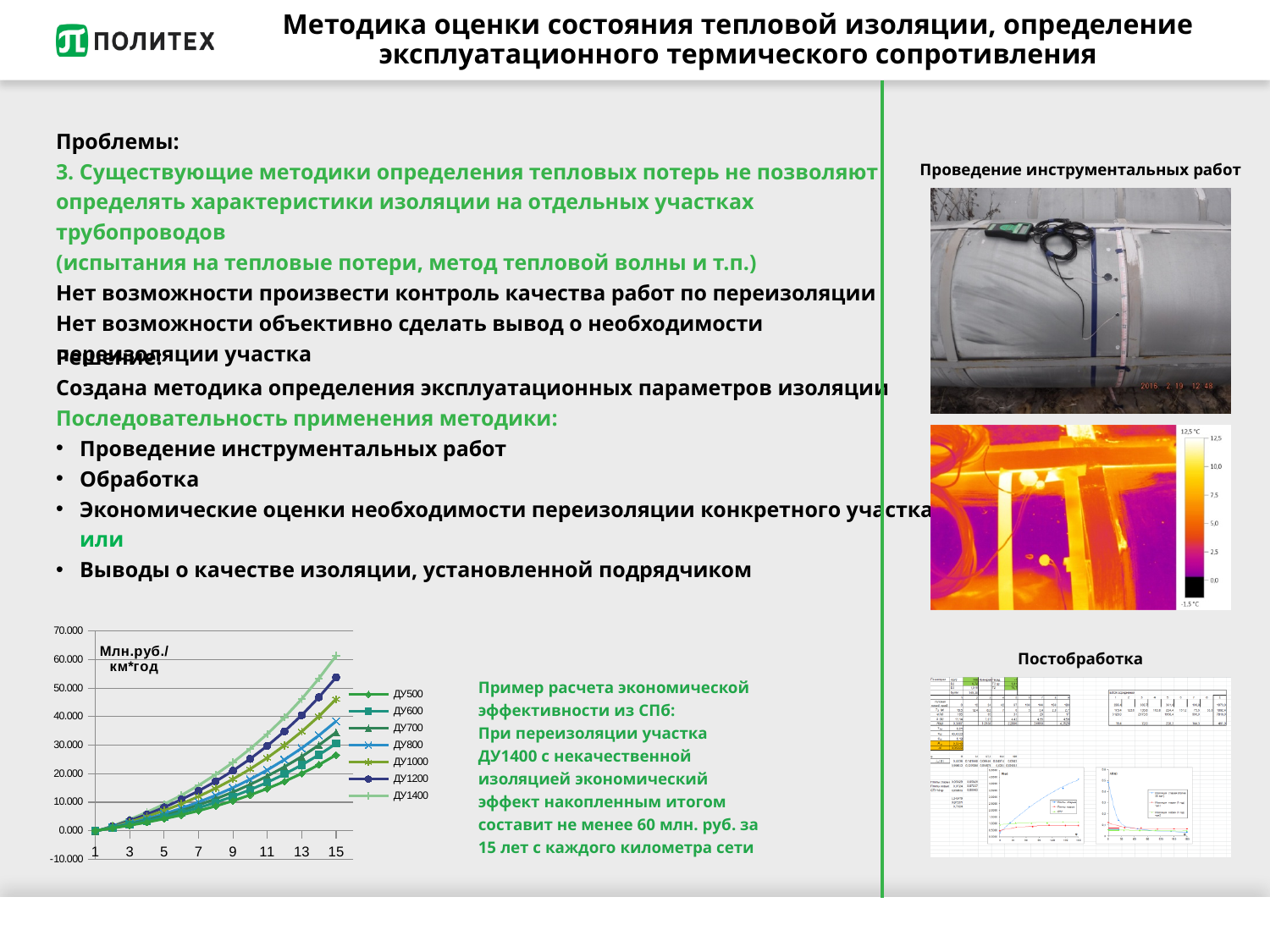
What is the first series listed in the legend of the line chart? ДУ500 Which series in the line chart has the highest value at x = 15? ДУ1400 How many series does the legend of the line chart list? 7 What kind of chart is shown at the bottom left of the slide? line chart Which series in the line chart has the lowest value at x = 15? ДУ500 What unit label is shown on the y axis of the line chart? Млн.руб./км*год In the line chart, which is larger at x = 15: ДУ600 or ДУ1000? ДУ1000 In the line chart, which is larger at x = 15: ДУ1200 or ДУ800? ДУ1200 In the line chart, is the value for ДУ1200 at x = 15 greater or less than 50.000? greater In the line chart, is the value for ДУ500 at x = 15 greater or less than 30.000? less Do the values in the line chart rise or fall as x increases from 1 to 15? rise In the line chart, is the value for ДУ1000 at x = 15 greater or less than 40.000? greater